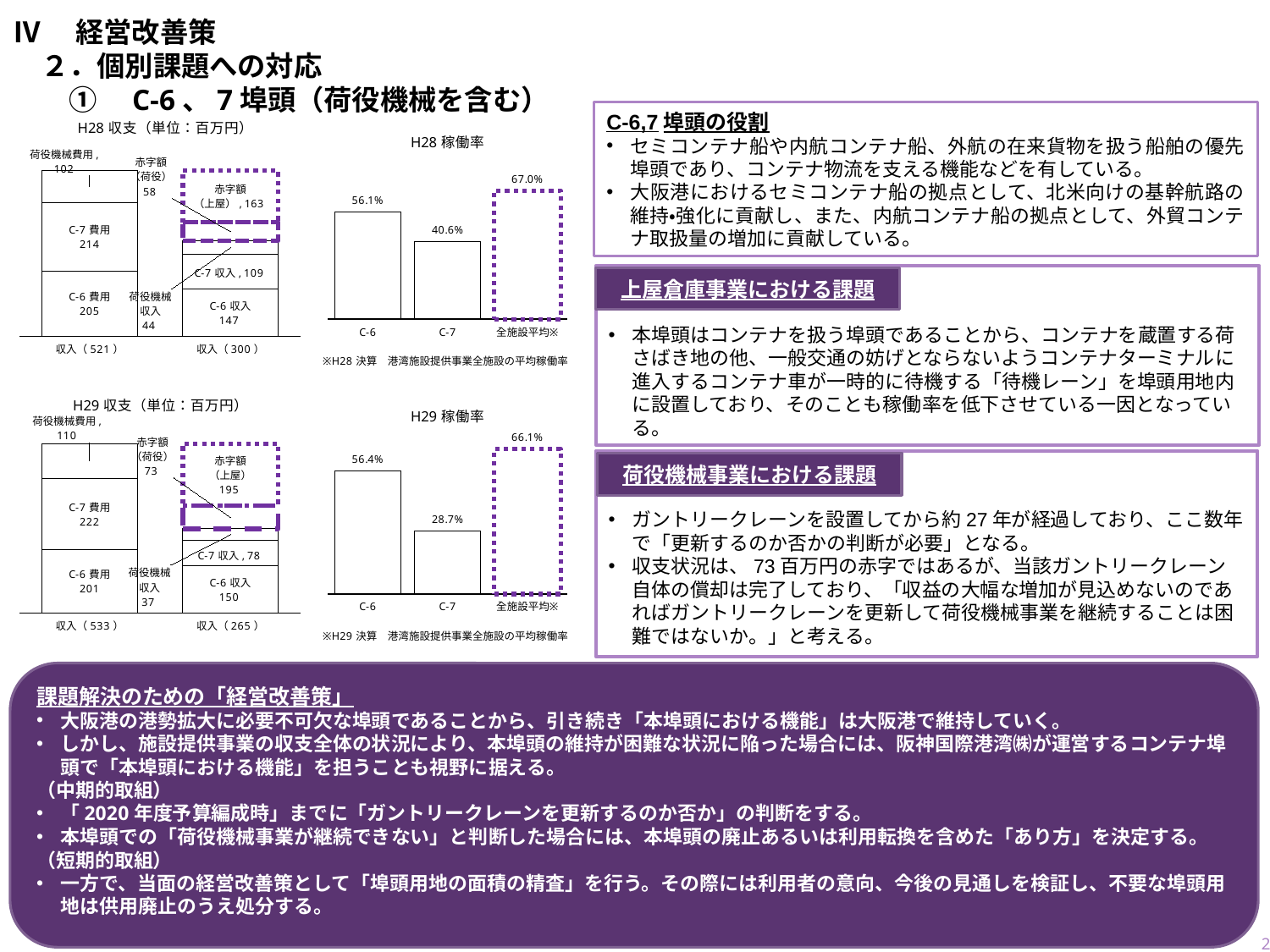
「H28 収支」のグラフで、収入の合計はいくらですか？ 300 「H28 稼働率」のグラフで、C-6 の稼働率はいくらですか？ 56.1% 「H28 稼働率」のグラフはどの種類のグラフですか？ 棒グラフ 「H28 稼働率」のグラフで、最も稼働率が高いのはどの項目ですか？ 全施設平均※ 「H29 収支」のグラフで、費用の合計はいくらですか？ 533 「H29 稼働率」のグラフで、C-6 と C-7 のどちらの稼働率が高いですか？ C-6 「H29 稼働率」のグラフで、最も稼働率が低いのはどの項目ですか？ C-7 「H28 収支」のグラフで、C-6 費用はいくらですか？ 205 「H29 稼働率」のグラフで、C-7 の稼働率はいくらですか？ 28.7% 「H28 稼働率」のグラフで、全施設平均と C-7 の稼働率の差はいくらですか？ 26.4% 「H29 稼働率」のグラフには棒がいくつありますか？ 3 「H29 収支」のグラフで、C-7 収入はいくらですか？ 78